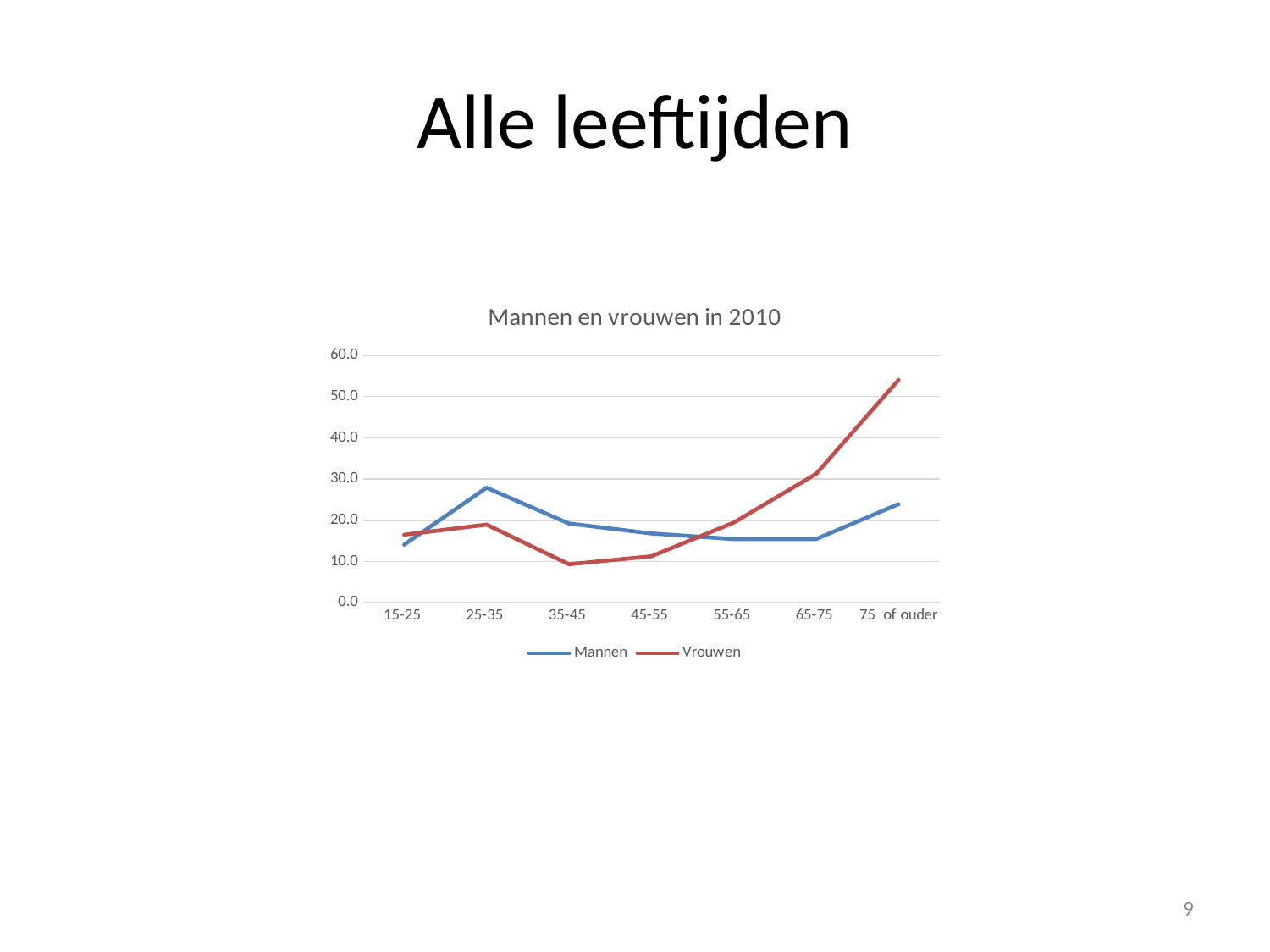
Is the Mannen value for 75 of ouder greater or less than 20.0? greater Is the Mannen value for 25-35 greater or less than 30.0? less For which age category is the Vrouwen value lowest? 35-45 Which series has the larger value for 75 of ouder, Mannen or Vrouwen? Vrouwen How many age categories are shown on the x axis? 7 Is the Vrouwen value for 75 of ouder greater or less than 50.0? greater Does the Vrouwen line rise or fall from 35-45 to 75 of ouder? rise What kind of chart is shown on the slide? line chart How many series does the legend list? 2 Which series has the larger value for 35-45, Mannen or Vrouwen? Mannen For which age category is the Mannen value highest? 25-35 For which age category is the Vrouwen value highest? 75 of ouder